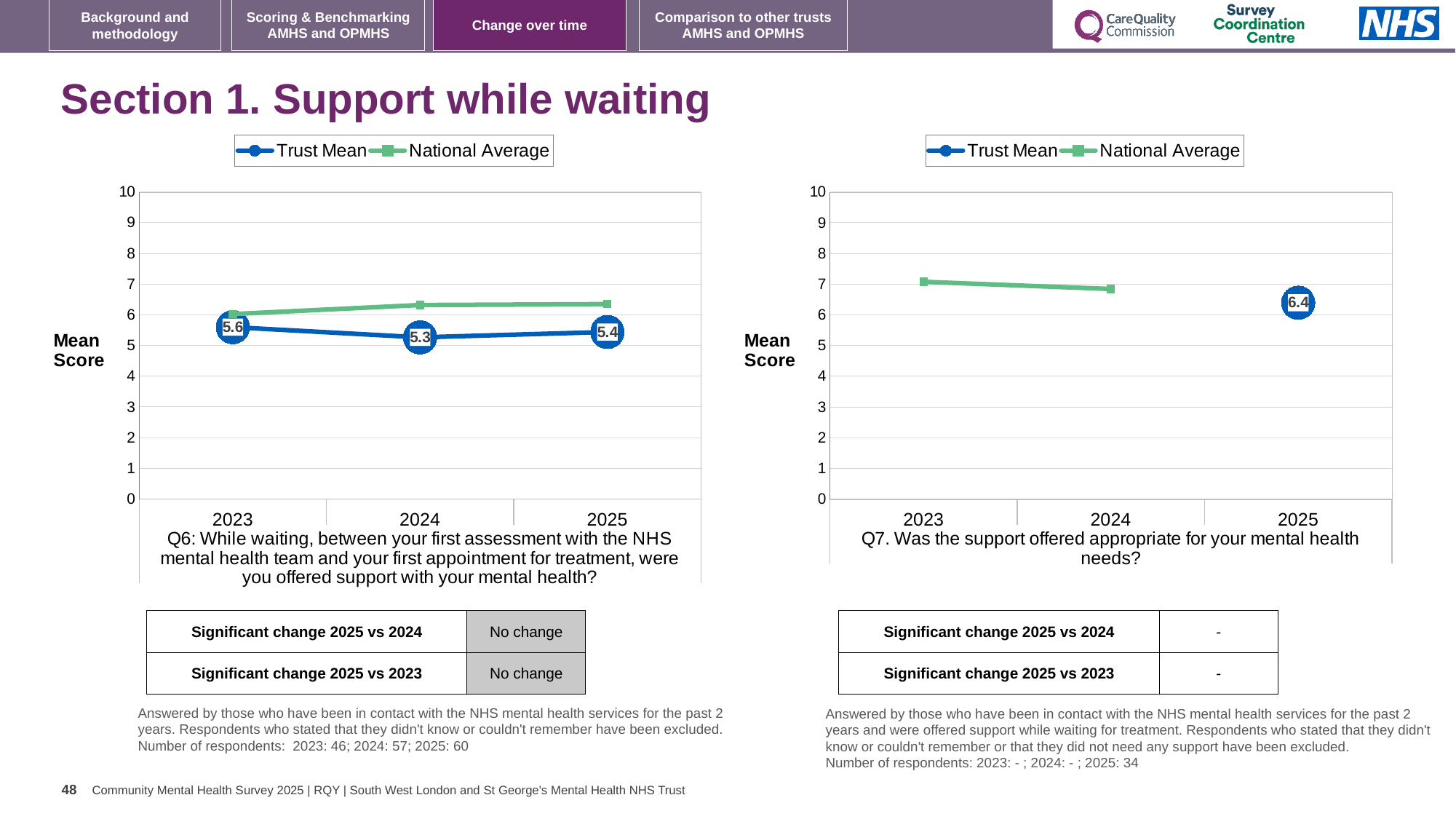
In the left chart (Q6), what is the Trust Mean score for 2024? 5.3 In the left chart (Q6), what is the Trust Mean score for 2023? 5.6 In the right chart (Q7), what is the Trust Mean score for 2025? 6.4 In the right chart (Q7), does the National Average rise or fall from 2023 to 2024? fall How many series does the legend of the left chart (Q6) list? 2 In the left chart (Q6), what is the Trust Mean score for 2025? 5.4 In the left chart (Q6), is the National Average for 2025 greater or less than 6? greater In the left chart (Q6), which is higher in 2025, the Trust Mean or the National Average? National Average In the left chart (Q6), what is the difference between the Trust Mean scores for 2023 and 2024? 0.3 What type of chart is the left chart (Q6)? line chart In the left chart (Q6), which year has the lowest Trust Mean score? 2024